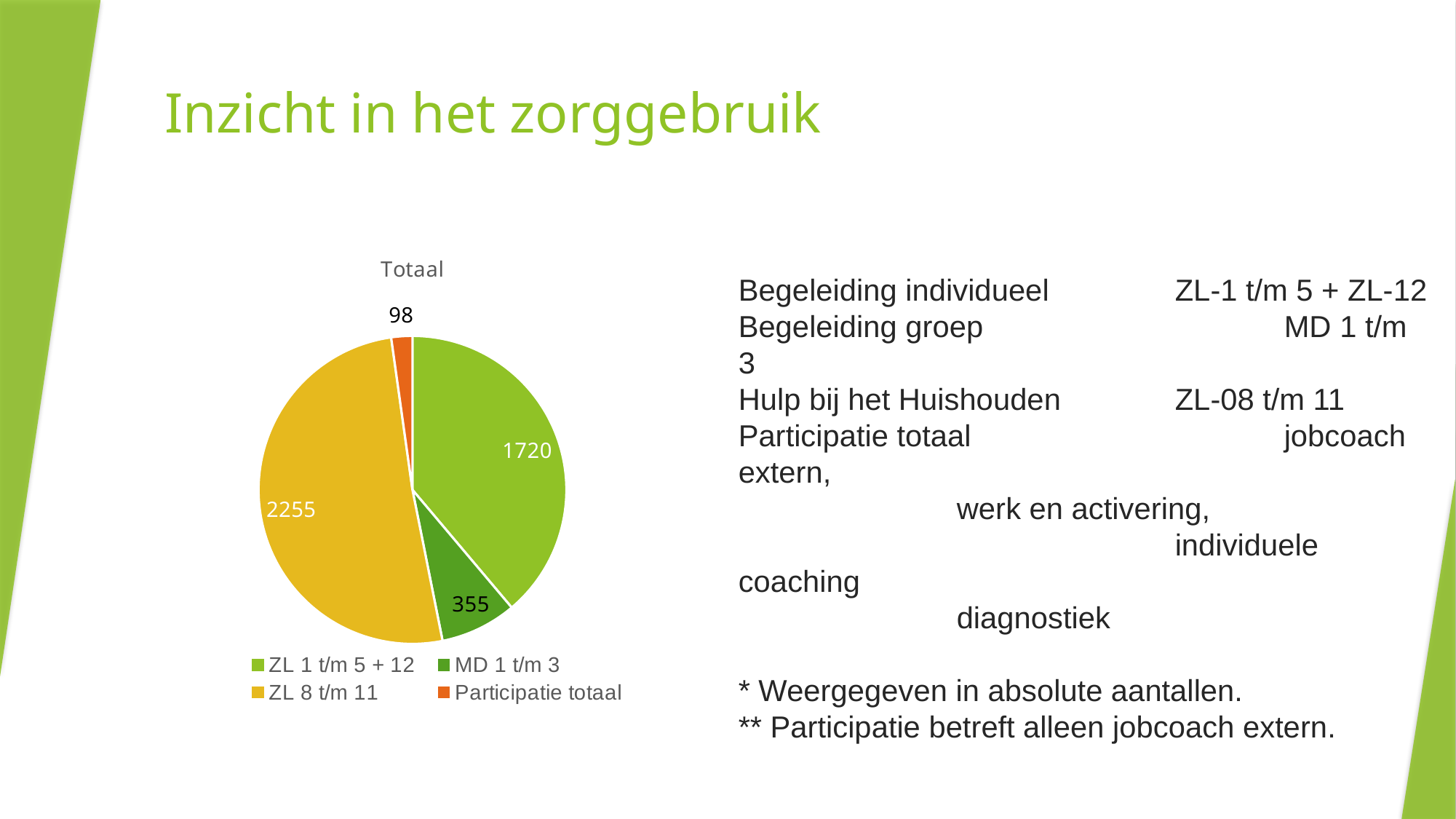
What is the difference between the values for ZL 8 t/m 11 and ZL 1 t/m 5 + 12? 535 How many slices does the pie chart have? 4 What is the total of all the values shown in the pie chart? 4428 What is the title of the pie chart? Totaal What kind of chart is shown on the slide? Pie chart What is the value for ZL 1 t/m 5 + 12 in the pie chart? 1720 Which is larger, the value for MD 1 t/m 3 or the value for Participatie totaal? MD 1 t/m 3 What is the value for ZL 8 t/m 11 in the pie chart? 2255 Which category has the largest slice in the pie chart? ZL 8 t/m 11 Which category has the smallest slice in the pie chart? Participatie totaal What is the value for MD 1 t/m 3 in the pie chart? 355 What is the value for Participatie totaal in the pie chart? 98